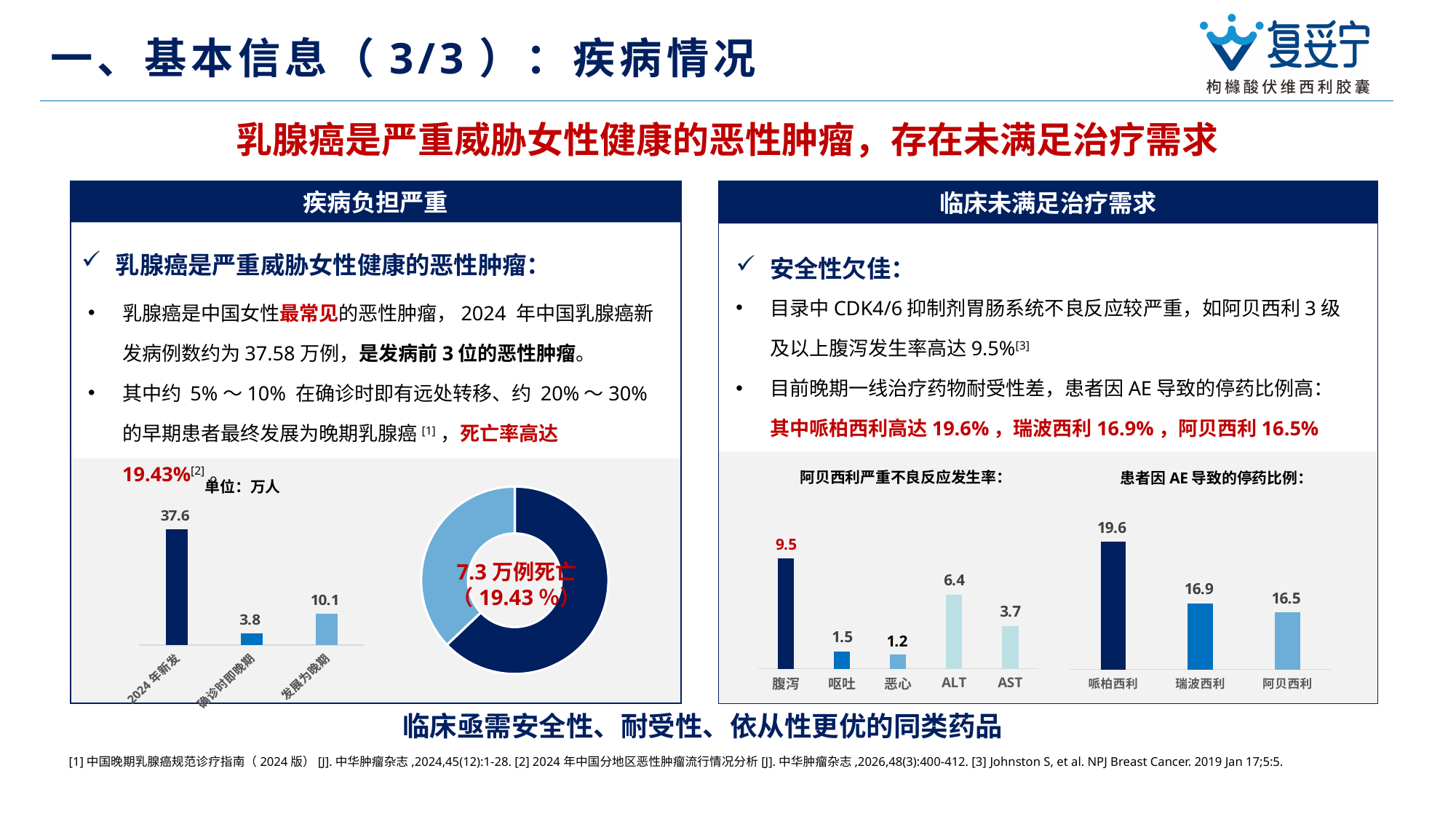
In the donut chart on the left panel, what percentage is shown for 7.3 万例死亡? 19.43% In the chart titled 阿贝西利严重不良反应发生率, what is the value for 腹泻? 9.5 In the bar chart on the left panel (单位：万人), what is the value for 发展为晚期? 10.1 In the bar chart on the left panel (单位：万人), what is the difference between 2024年新发 and 发展为晚期? 27.5 What kind of chart is the chart in the left panel that shows 7.3 万例死亡? Donut chart In the bar chart on the left panel (单位：万人), what is the value for 2024年新发? 37.6 In the bar chart on the left panel (单位：万人), how many categories are shown? 3 In the chart titled 阿贝西利严重不良反应发生率, which category has the lowest value? 恶心 In the chart titled 患者因 AE 导致的停药比例, which category has the highest value? 哌柏西利 In the chart titled 患者因 AE 导致的停药比例, which is larger, 瑞波西利 or 阿贝西利? 瑞波西利 In the chart titled 阿贝西利严重不良反应发生率, what is the difference between ALT and AST? 2.7 In the bar chart on the left panel (单位：万人), which category has the lowest value? 确诊时即晚期